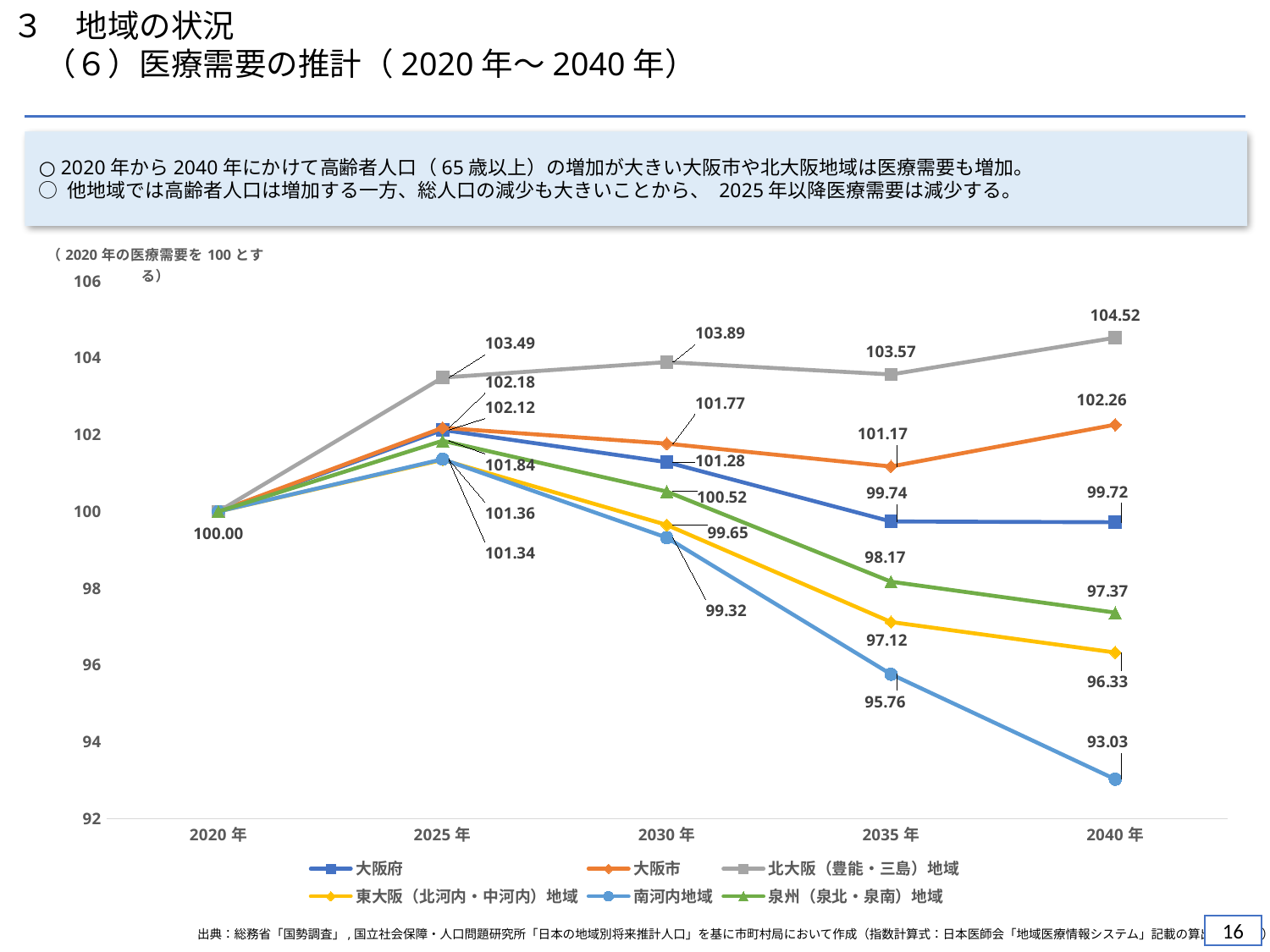
What is the value for 大阪市 in 2035年? 101.17 Which series has the lowest value in 2040年? 南河内地域 What is the difference between the 2040年 values of 北大阪（豊能・三島）地域 and 南河内地域? 11.49 What is the value for 泉州（泉北・泉南）地域 in 2035年? 98.17 How many series does the legend list? 6 What kind of chart is shown on the slide? line chart How many years are shown along the x axis? 5 Which series has the highest value in 2040年? 北大阪（豊能・三島）地域 What is the value for 北大阪（豊能・三島）地域 in 2040年? 104.52 In 2030年, which is larger: the value for 大阪府 or the value for 泉州（泉北・泉南）地域? 大阪府 What is the value for 南河内地域 in 2040年? 93.03 Does the value for 南河内地域 rise or fall from 2025年 to 2040年? fall